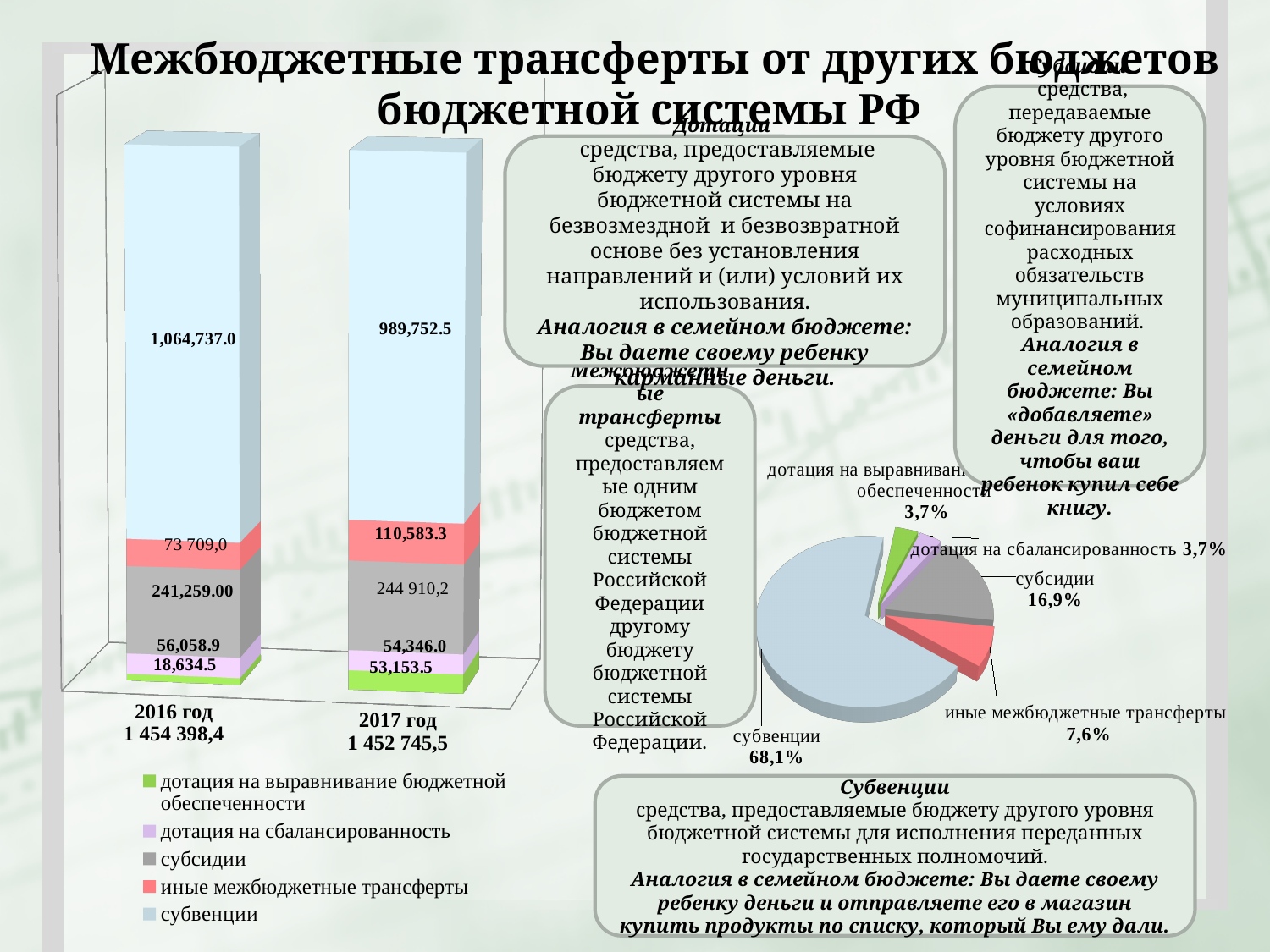
On the stacked bar chart, what is the value of дотация на выравнивание бюджетной обеспеченности for 2016 год? 18,634.5 On the stacked bar chart, what is the value of субсидии for 2017 год? 244 910,2 On the stacked bar chart, what is the value of иные межбюджетные трансферты for 2017 год? 110,583.3 On the stacked bar chart, how many series does the legend list? 5 On the stacked bar chart, what is the total shown for 2017 год? 1 452 745,5 What type of chart is shown on the left side of the slide? Stacked bar chart On the stacked bar chart, how many years are shown? 2 On the stacked bar chart, which year has the larger value for субвенции, 2016 год or 2017 год? 2016 год On the pie chart, what share do субсидии have? 16,9% On the pie chart, which category has the largest share? субвенции On the stacked bar chart, what is the value of субвенции for 2016 год? 1,064,737.0 On the pie chart, what share do субвенции have? 68,1%